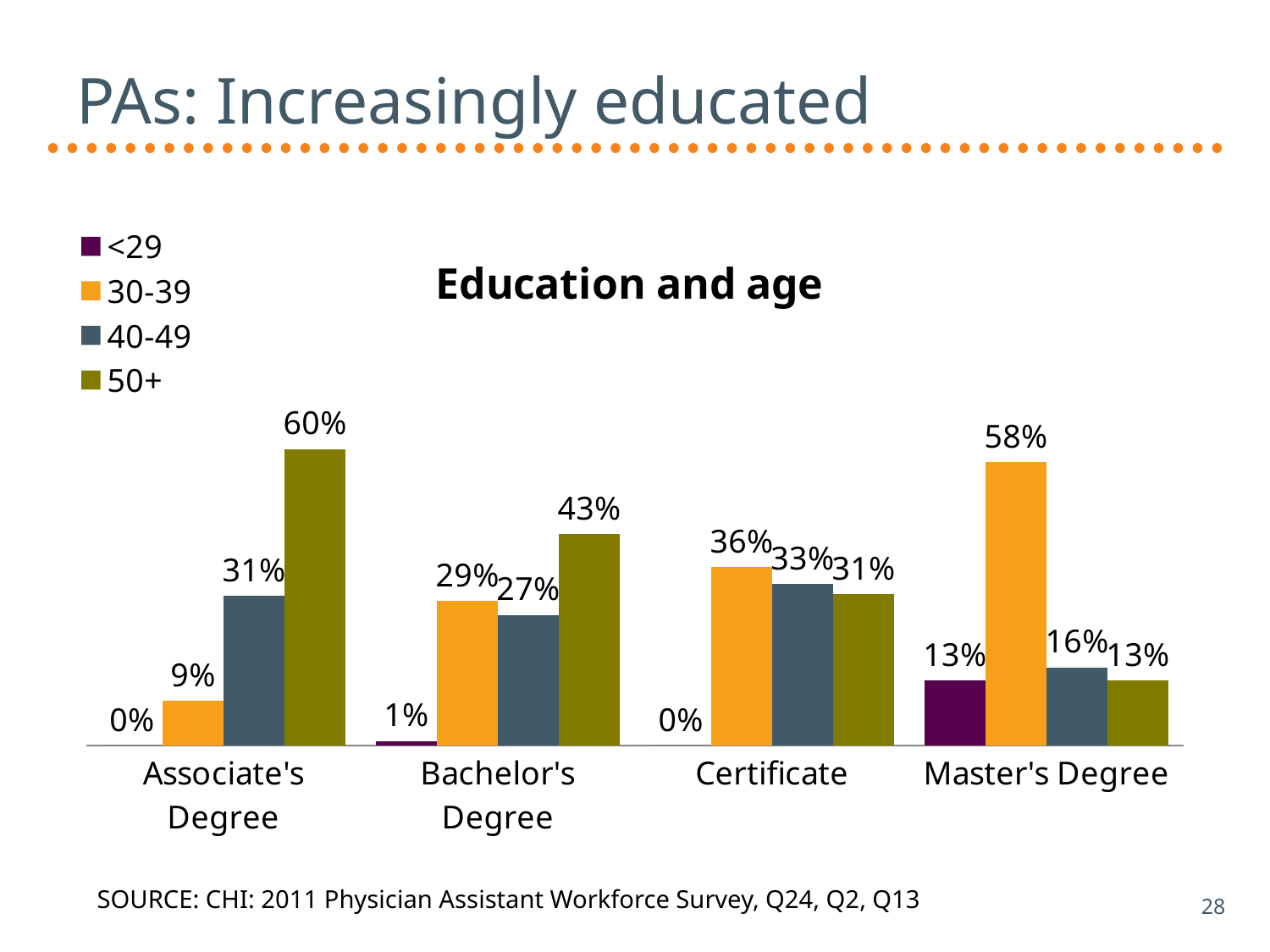
What is the value for the <29 series in the Bachelor's Degree category? 1% What is the value for the 50+ series in the Associate's Degree category? 60% Which is larger in the Bachelor's Degree category: the 30-39 value or the 40-49 value? 30-39 Which education category has the highest value for the 30-39 series? Master's Degree Which education category has the lowest value for the 50+ series? Master's Degree What is the value for the 30-39 series in the Master's Degree category? 58% How many education categories are shown on the x axis? 4 How many series does the legend list? 4 What is the title of the chart? Education and age What is the difference between the 50+ value and the 40-49 value in the Associate's Degree category? 29% What kind of chart is shown on the slide? Bar chart What is the value for the 40-49 series in the Certificate category? 33%